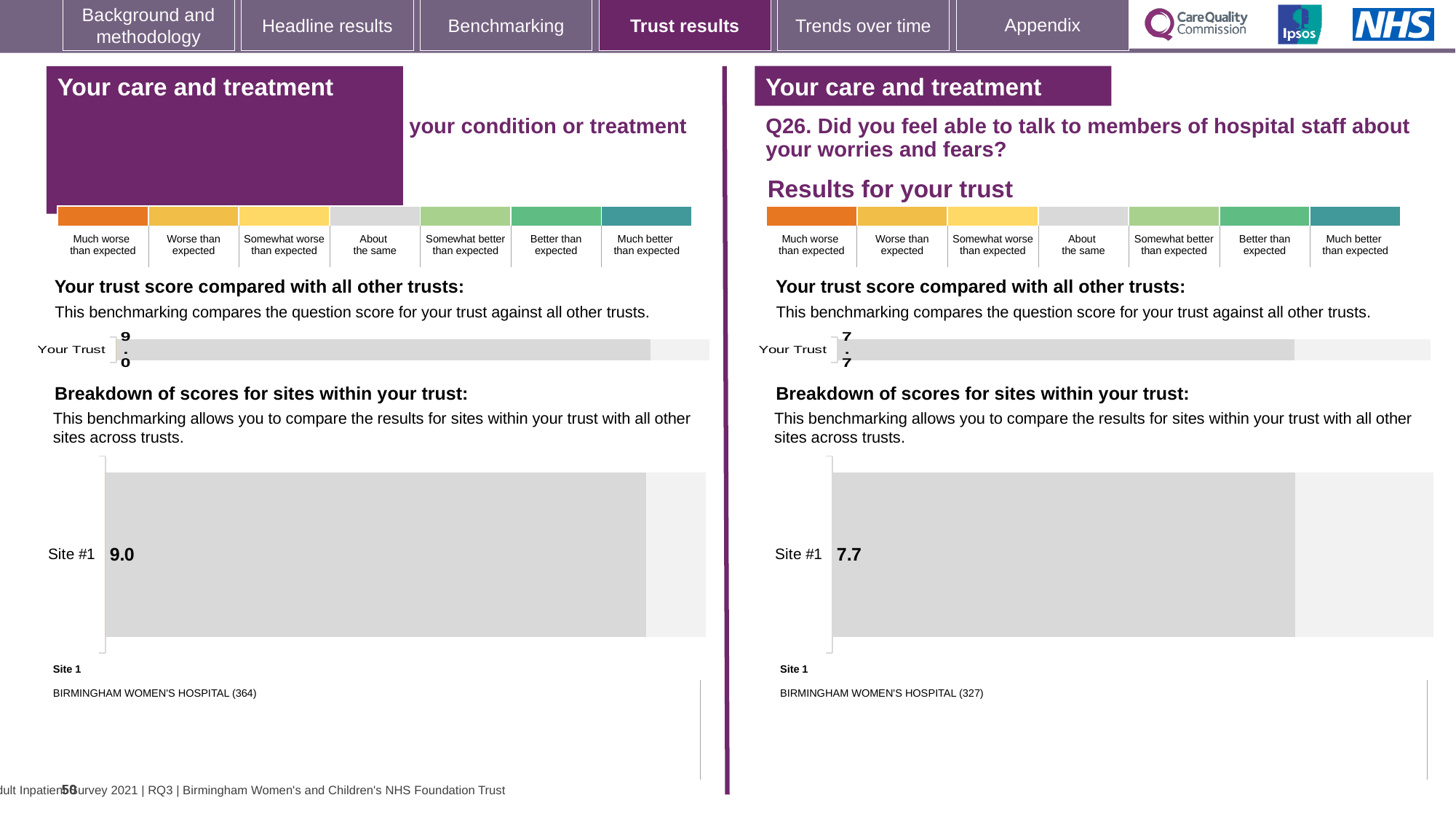
What type of chart is used for 'Your trust score compared with all other trusts' on the left panel? Bar chart On the right panel's 'Breakdown of scores for sites within your trust' chart, what is the value for Site #1? 7.7 Which is larger: the Your Trust score on the left panel or the Your Trust score on the right panel? Left panel What is the name of Site 1 listed below the right panel's site breakdown chart? BIRMINGHAM WOMEN'S HOSPITAL (327) What is the difference between the Site #1 score on the left panel and the Site #1 score on the right panel? 1.3 On the right panel's 'Your trust score compared with all other trusts' chart, what is the value for Your Trust? 7.7 On the left panel's 'Your trust score compared with all other trusts' chart, what is the value for Your Trust? 9.0 Which question is the right panel's charts about? Q26. Did you feel able to talk to members of hospital staff about your worries and fears? What type of chart is used for the 'Breakdown of scores for sites within your trust' on the right panel? Bar chart How many categories are shown on the left panel's 'Your trust score compared with all other trusts' chart? 1 How many sites are shown on the right panel's 'Breakdown of scores for sites within your trust' chart? 1 On the left panel's 'Breakdown of scores for sites within your trust' chart, what is the value for Site #1? 9.0